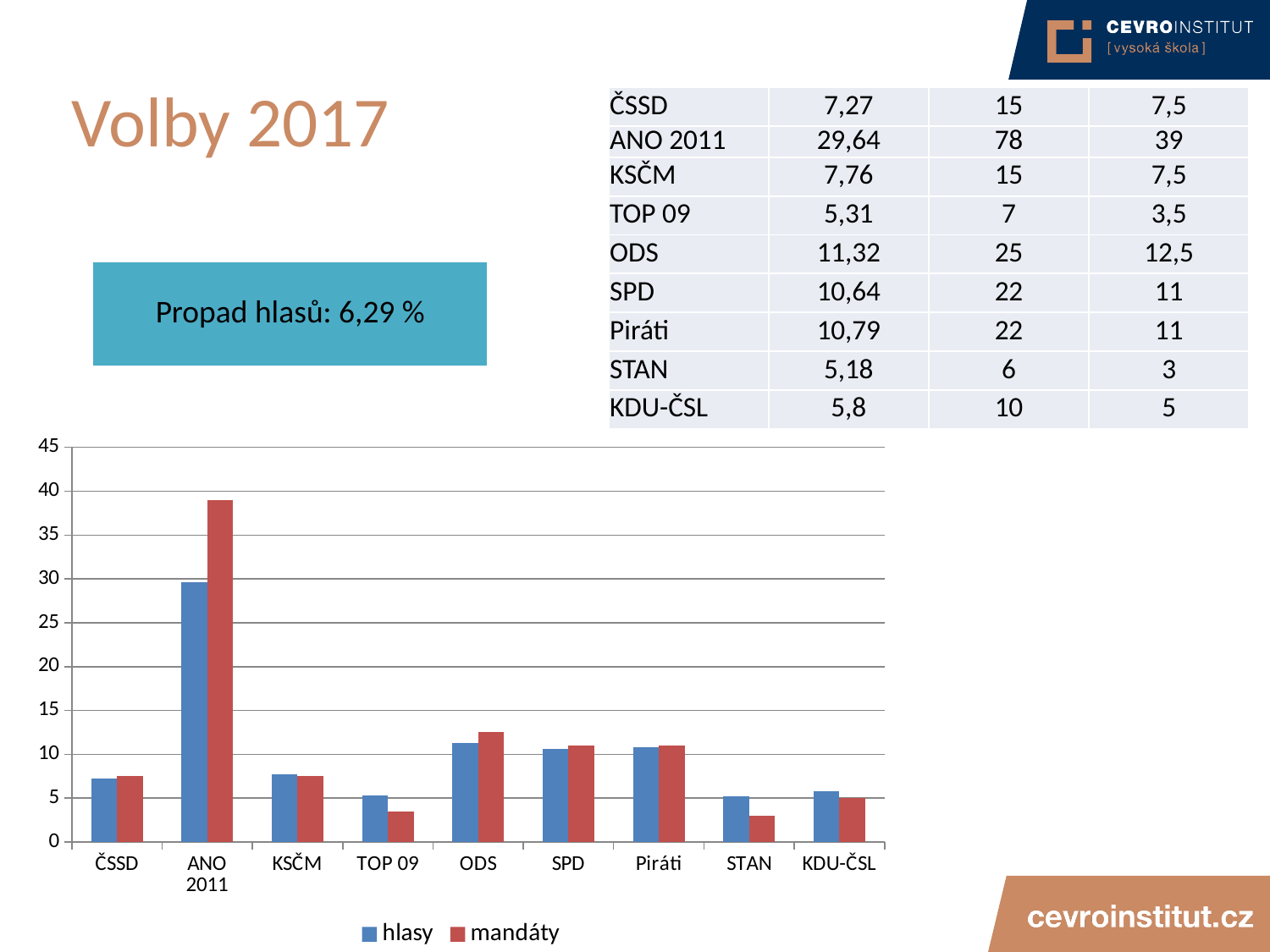
Which party has the lowest value for mandáty in the chart? STAN What colour are the mandáty bars in the chart? red Is the hlasy value for ODS greater or less than 10? greater For ANO 2011, which is larger in the chart: hlasy or mandáty? mandáty What are the two legend entries of the chart? hlasy, mandáty How many parties are shown on the x axis of the chart? 9 What kind of chart is shown on the slide? bar chart Which party has the highest value for hlasy in the chart? ANO 2011 How many series does the chart legend list? 2 For STAN, which is larger in the chart: hlasy or mandáty? hlasy Is the mandáty value for TOP 09 greater or less than 5? less Is the mandáty value for ANO 2011 greater or less than 35? greater